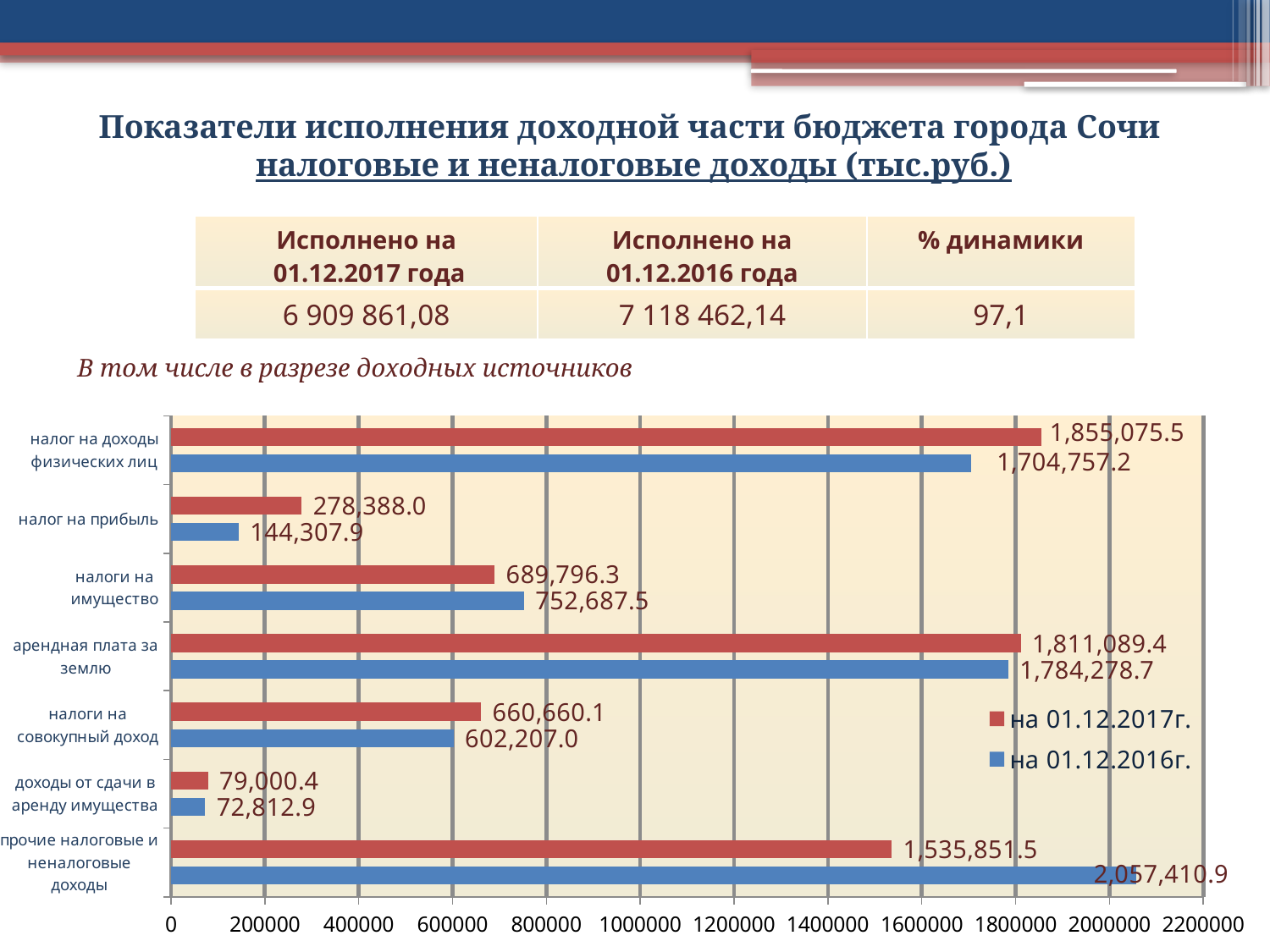
For налоги на совокупный доход, which series has the larger value: на 01.12.2017г. or на 01.12.2016г.? на 01.12.2017г. What is the difference between the 2017 and 2016 values for налог на прибыль? 134,080.1 Which category has the highest value in the series на 01.12.2016г.? прочие налоговые и неналоговые доходы What is the value for прочие налоговые и неналоговые доходы in the series на 01.12.2016г.? 2,057,410.9 What kind of chart is shown on the slide? bar chart What is the difference between the 2016 and 2017 values for налоги на имущество? 62,891.2 Which category has the lowest value in the series на 01.12.2017г.? доходы от сдачи в аренду имущества What is the value for налог на доходы физических лиц in the series на 01.12.2017г.? 1,855,075.5 How many categories are shown on the chart? 7 What is the value for налоги на имущество in the series на 01.12.2016г.? 752,687.5 Which category has the highest value in the series на 01.12.2017г.? налог на доходы физических лиц How many series does the legend list? 2